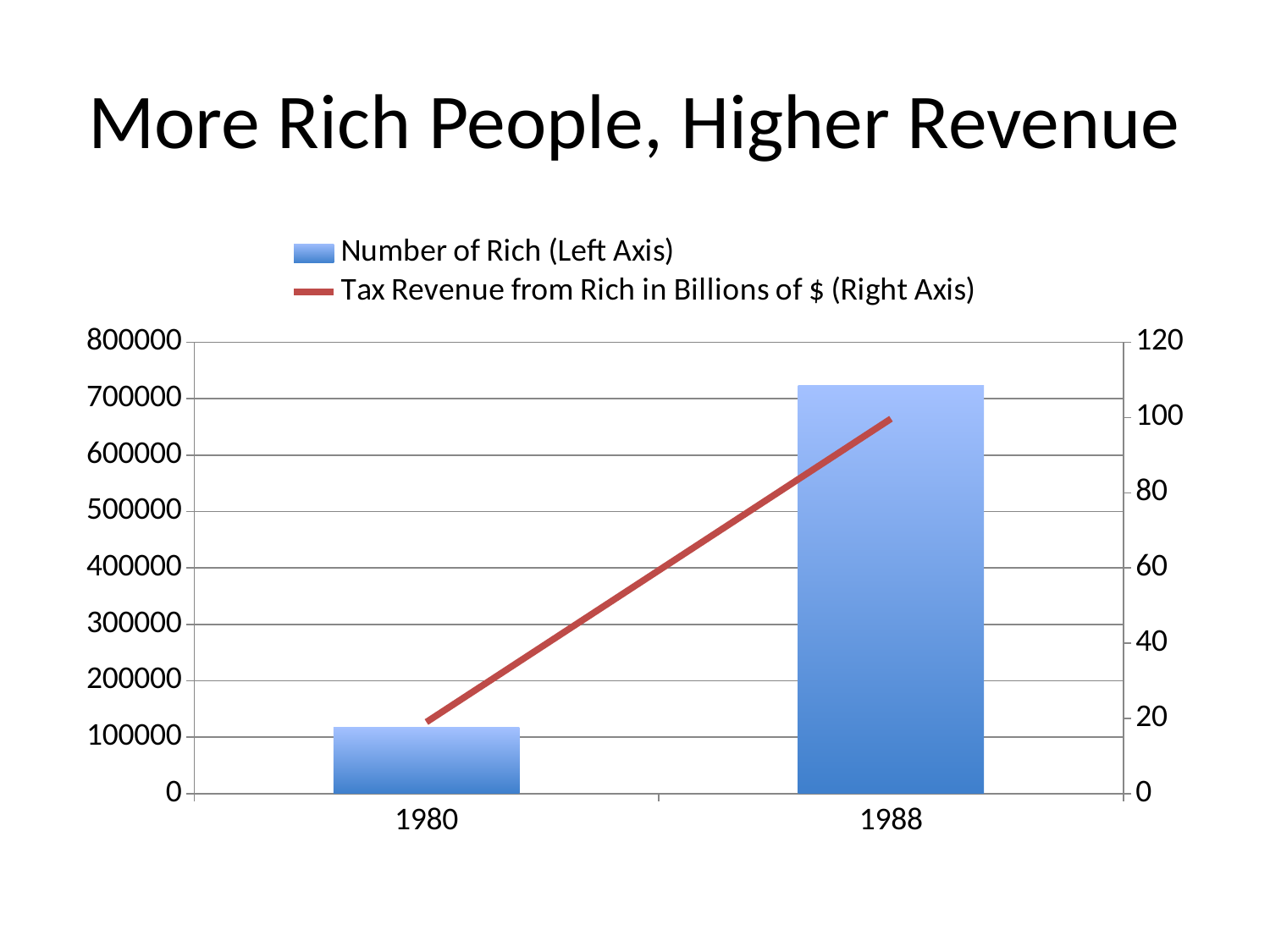
How many series does the legend list? 2 Is the Tax Revenue from Rich larger in 1980 or in 1988? 1988 Which year has the higher Number of Rich? 1988 How many categories are shown on the x axis? 2 Is the Number of Rich for 1980 greater or less than 200000? less Which series is plotted as a line? Tax Revenue from Rich in Billions of $ (Right Axis) What is the title of the chart? More Rich People, Higher Revenue Is the Tax Revenue from Rich for 1988 greater or less than 80 billion dollars? greater Does the Tax Revenue from Rich rise or fall from 1980 to 1988? rise Which year has the lower Number of Rich? 1980 Is the Number of Rich for 1988 greater or less than 600000? greater